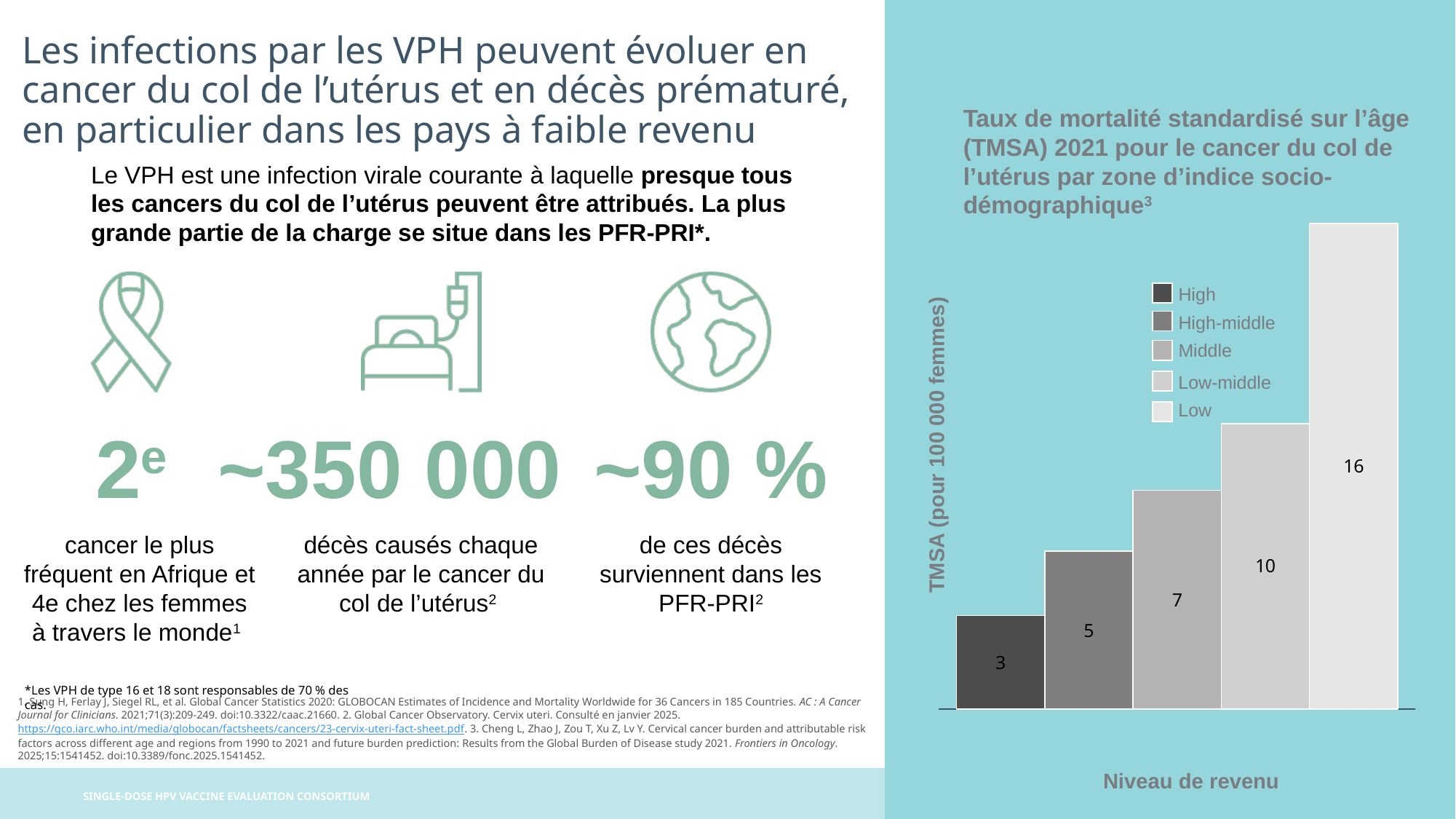
What type of chart is shown on the slide? Bar chart What is the difference in TMSA between the Low-middle and High-middle income levels? 5 Which income level has the highest TMSA? Low What is the TMSA value for the Middle income level? 7 Which has a higher TMSA, Middle or High-middle? Middle What is the TMSA value for the High income level? 3 What is the TMSA value for the Low income level? 16 Do the TMSA values rise or fall from High to Low income level? Rise Which income level has the lowest TMSA? High How many entries does the legend list? 5 What is the difference in TMSA between the Low and High income levels? 13 How many income levels are shown in the chart? 5